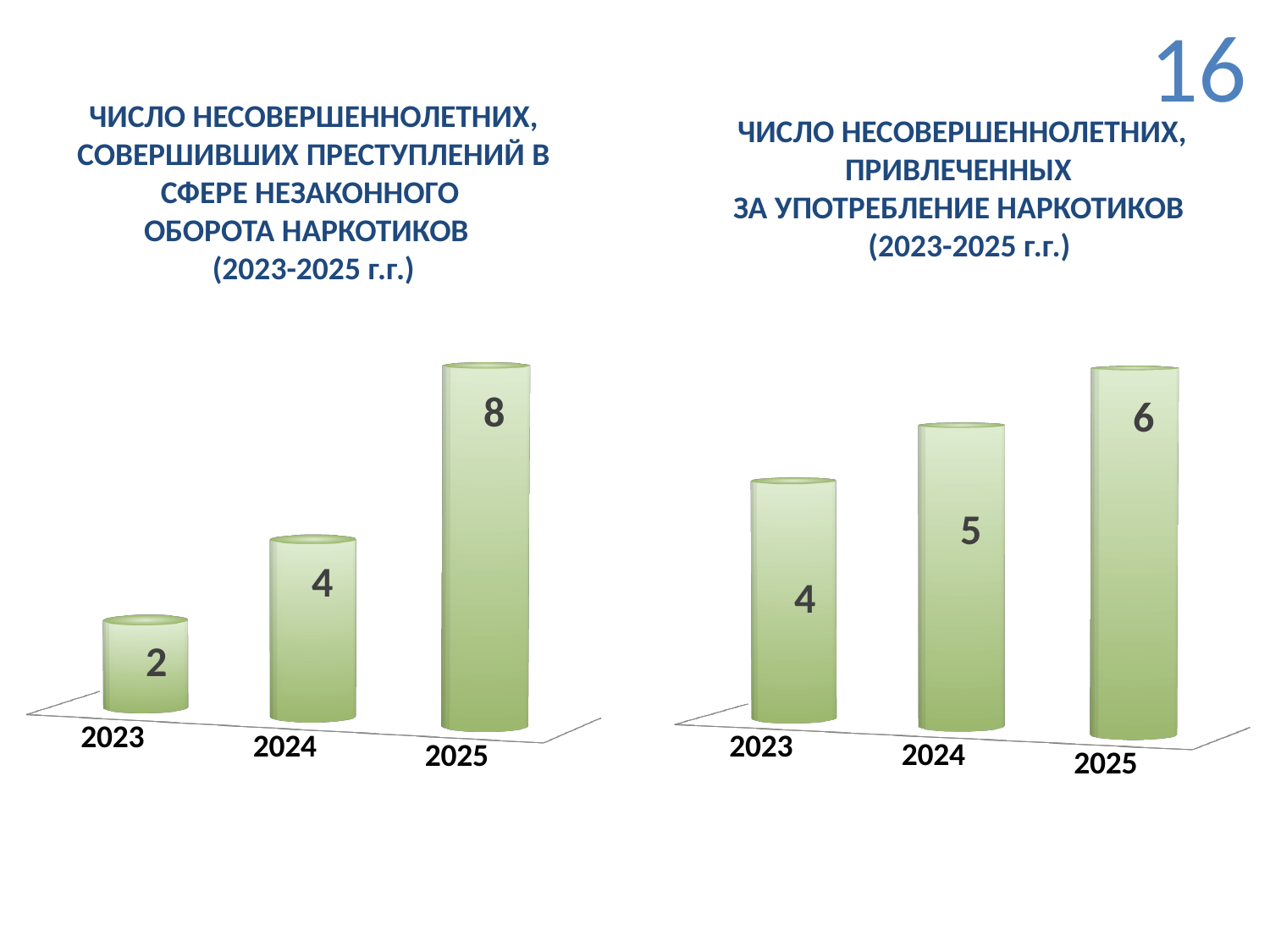
What kind of chart is the left chart? bar chart In the right chart, do the values rise or fall from 2023 to 2025? rise In the left chart, which is larger: the value for 2024 or the value for 2023? 2024 In the left chart, what is the difference between the values for 2025 and 2023? 6 In the left chart (number of minors who committed drug trafficking crimes), what is the value for 2025? 8 In the left chart, which year has the highest value? 2025 How many years are shown in the right chart? 3 In the right chart (number of minors held liable for drug use), what is the value for 2023? 4 In the right chart (number of minors held liable for drug use), what is the value for 2024? 5 In the right chart, which year has the lowest value? 2023 In the left chart (number of minors who committed drug trafficking crimes), what is the value for 2023? 2 In the right chart, what is the difference between the values for 2025 and 2024? 1